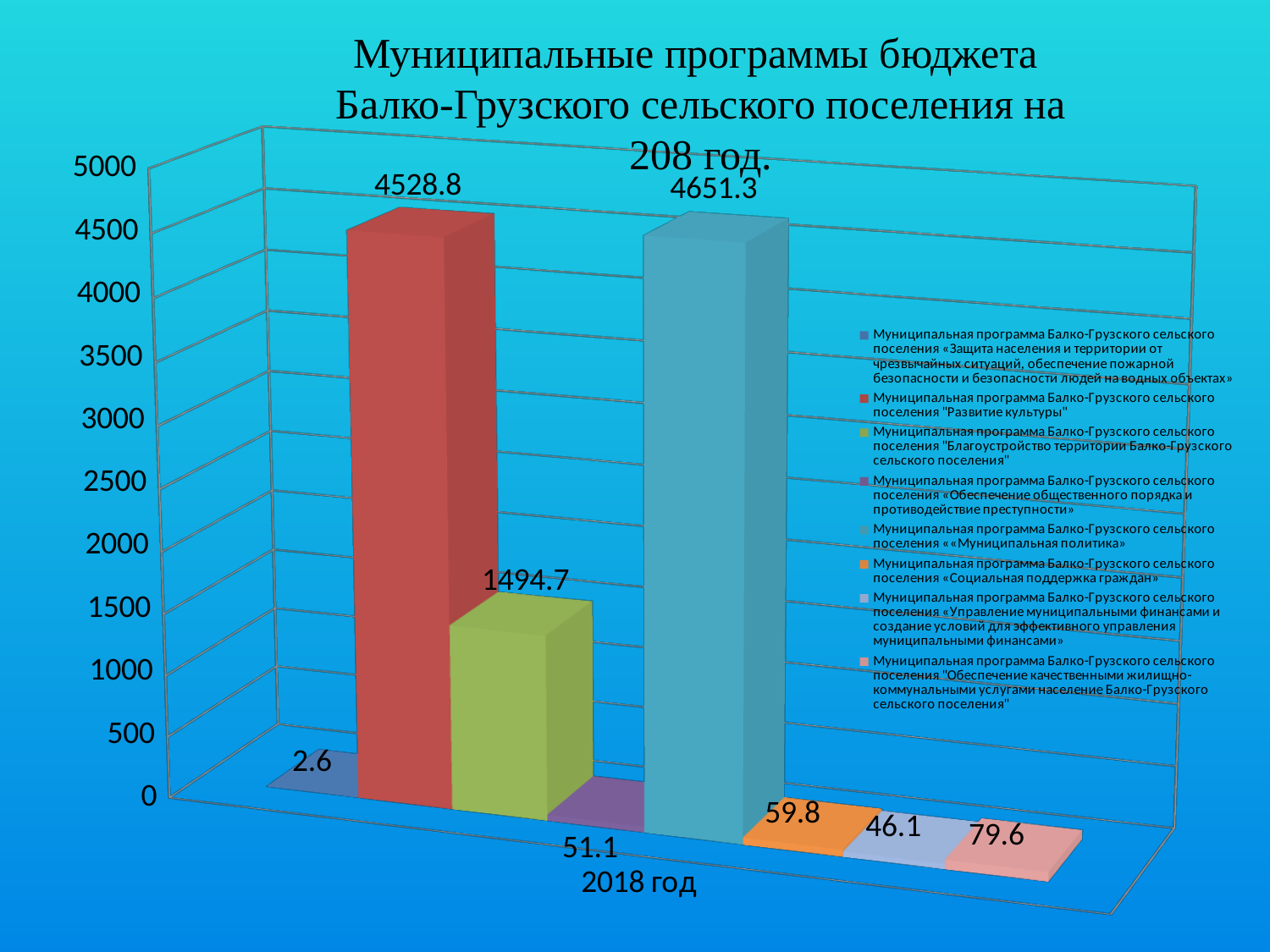
What category label is shown on the x axis? 2018 год How many series does the legend list? 8 Which programme has the lowest value on the chart? Защита населения и территории от чрезвычайных ситуаций, обеспечение пожарной безопасности и безопасности людей на водных объектах What type of chart is shown on the slide? bar chart Which is larger: the value for "Обеспечение качественными жилищно-коммунальными услугами" or for "Управление муниципальными финансами"? Обеспечение качественными жилищно-коммунальными услугами Which programme has the highest value on the chart? Муниципальная политика What is the value for the programme "Муниципальная политика" in 2018 год? 4651.3 Is the value for "Благоустройство территории" greater or less than 1000? greater What is the value for the programme "Развитие культуры" in 2018 год? 4528.8 What is the value for the programme "Благоустройство территории Балко-Грузского сельского поселения"? 1494.7 What is the value for the programme "Социальная поддержка граждан"? 59.8 What is the difference between the values for "Муниципальная политика" and "Развитие культуры"? 122.5